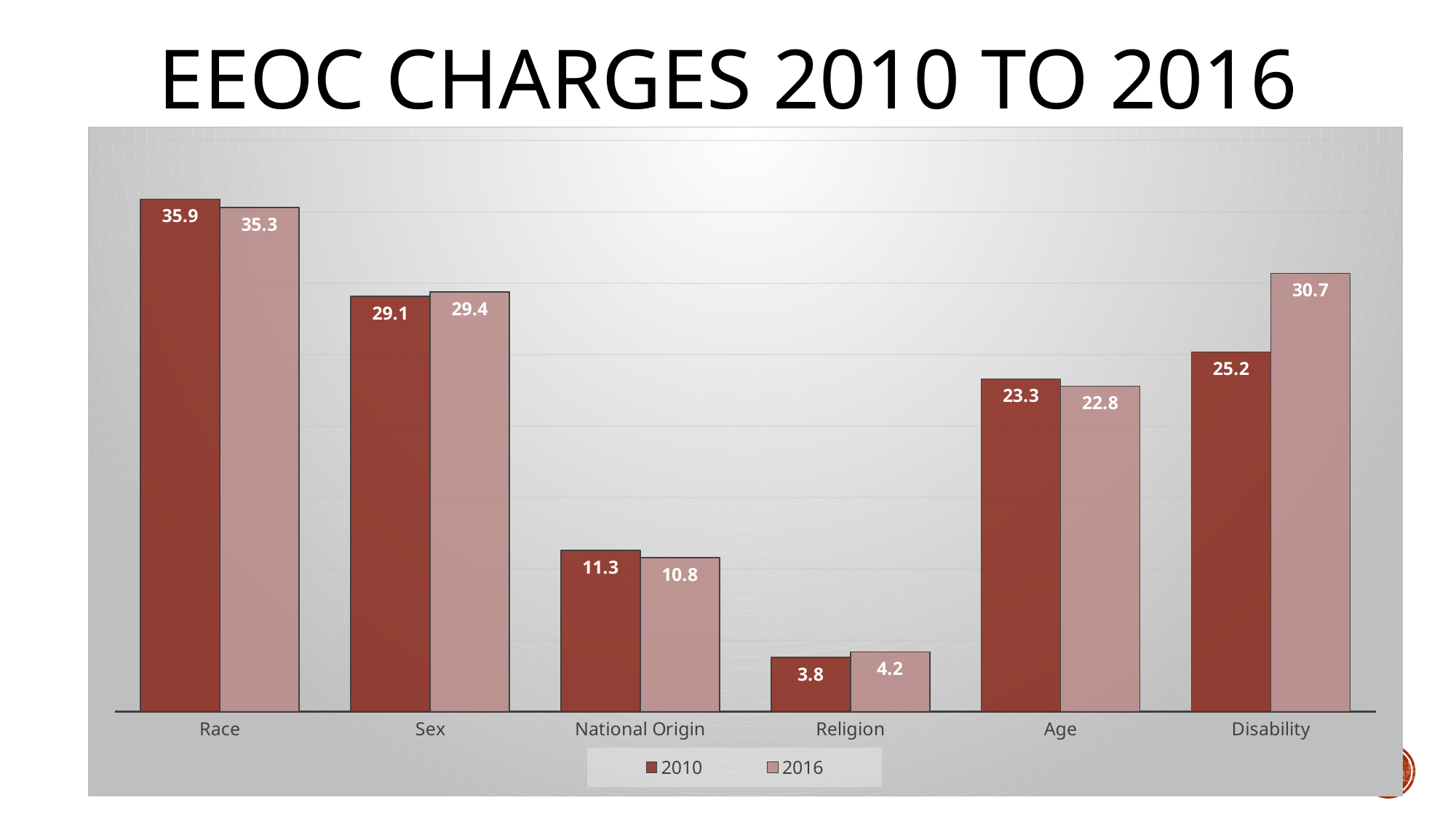
What kind of chart is shown on the slide? Bar chart What is the title of the chart? EEOC Charges 2010 to 2016 What is the difference between the 2010 and 2016 values for Race? 0.6 What is the difference between the 2016 and 2010 values for Disability? 5.5 Which category has the lowest 2016 value? Religion How many series does the legend list? 2 Which category has the highest 2010 value? Race What is the 2016 value for Disability? 30.7 What is the 2010 value for Race? 35.9 How many categories are shown on the x axis? 6 What is the 2016 value for National Origin? 10.8 Which is larger for Age: the 2010 value or the 2016 value? 2010